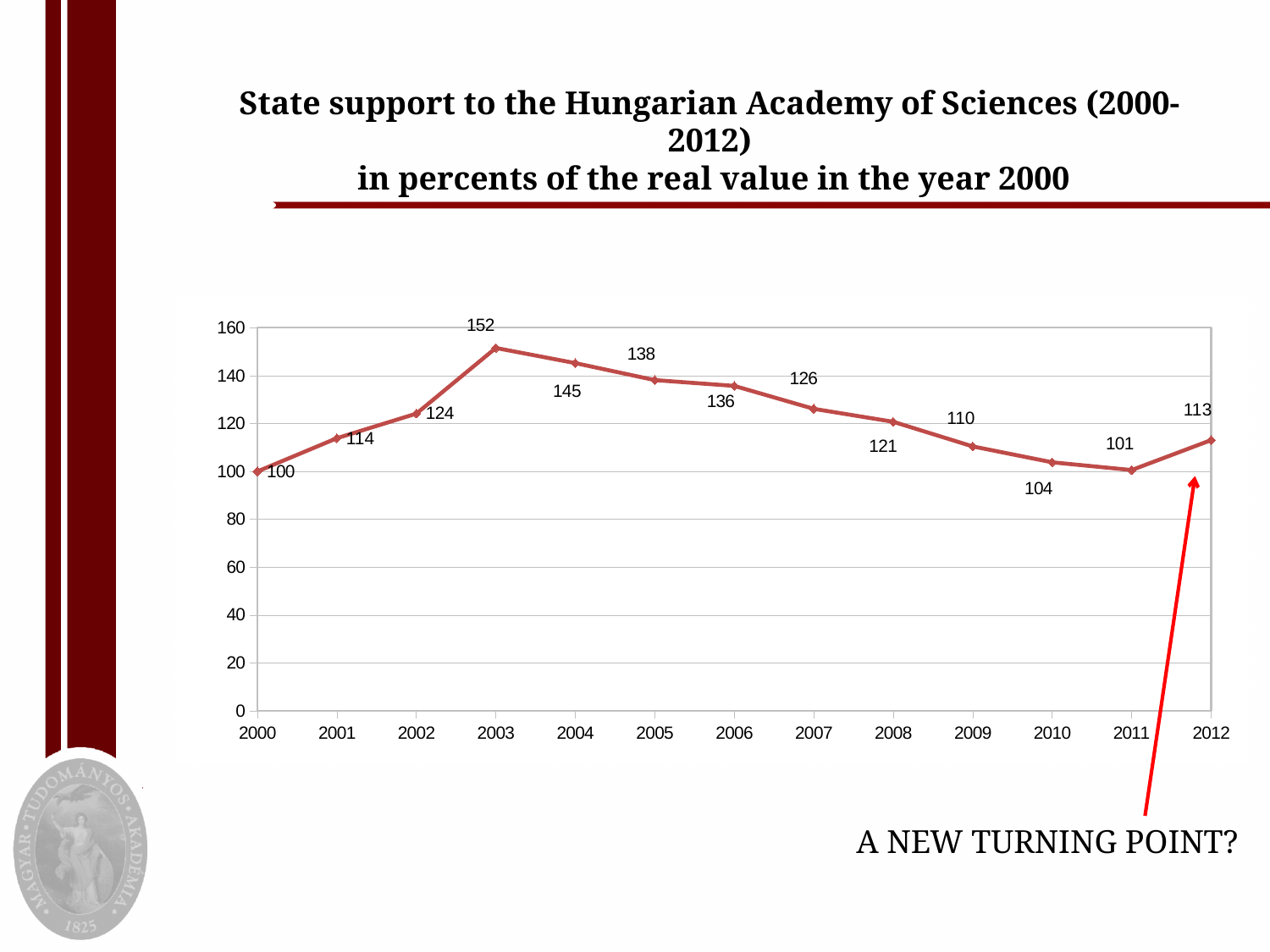
How many years are plotted on the x axis? 13 Which year has the lowest value? 2000 Which is larger, the value for 2004 or the value for 2007? 2004 What is the value for 2011? 101 Do the values rise or fall from 2003 to 2011? fall What is the value for 2003? 152 What is the difference between the values for 2012 and 2011? 12 Is the value for 2005 greater or less than 120? greater What is the difference between the values for 2003 and 2011? 51 What kind of chart is shown? line chart What is the value for 2008? 121 Which year has the highest value? 2003